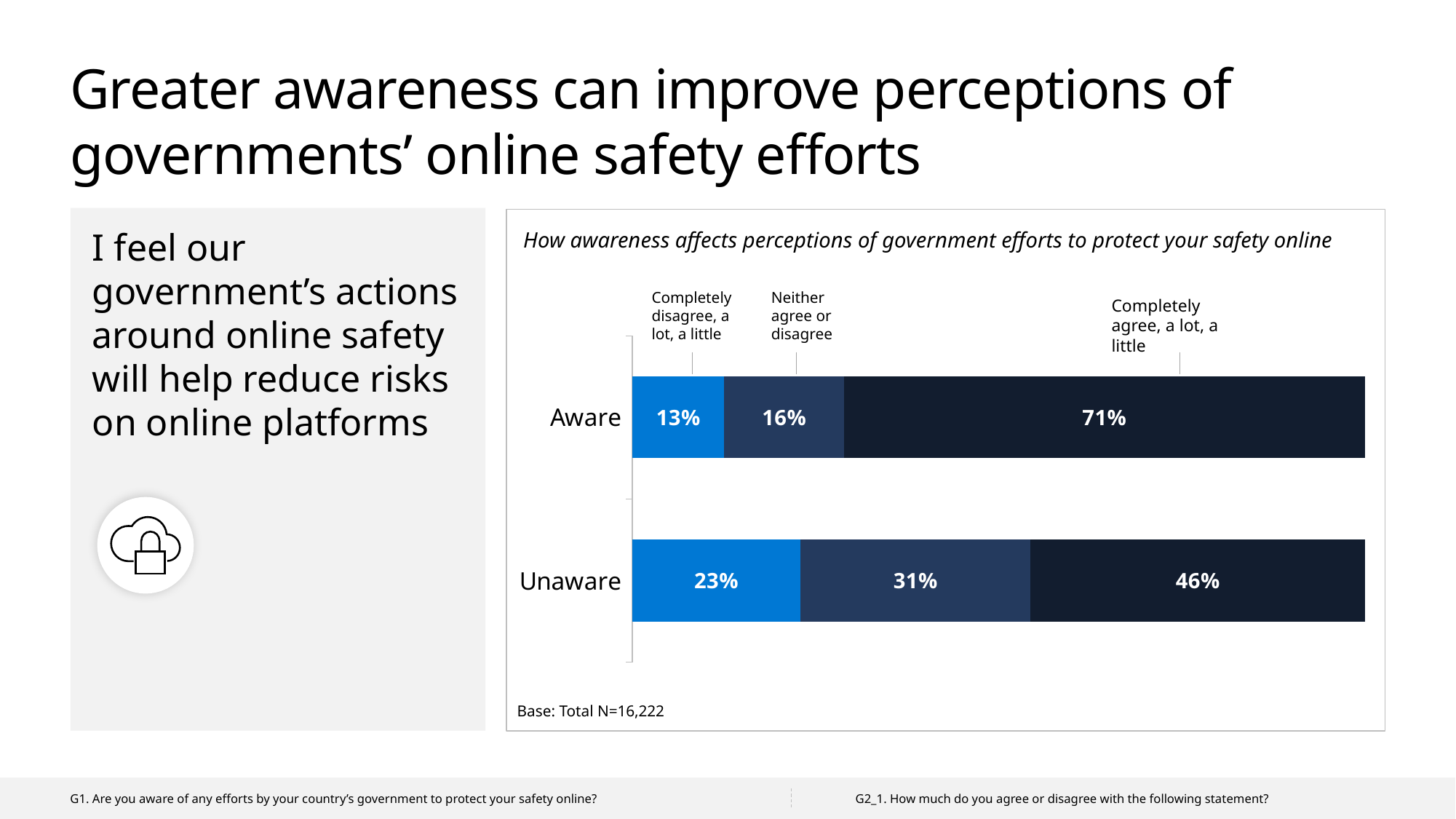
What percentage of Aware respondents neither agree nor disagree? 16% Which group has the higher share of respondents who agree (completely, a lot, a little): Aware or Unaware? Aware What is the difference in the disagree share between Unaware and Aware respondents? 10 percentage points How many groups (bars) are shown in the chart? 2 What percentage of Unaware respondents completely disagree, disagree a lot, or disagree a little? 23% What percentage of Aware respondents completely agree, agree a lot, or agree a little? 71% How many response categories are shown in each bar? 3 What is the difference in the agree share between Aware and Unaware respondents? 25 percentage points What percentage of Unaware respondents neither agree nor disagree? 31% What type of chart is shown on the slide? Stacked bar chart Which group has the larger share of respondents who neither agree nor disagree? Unaware What is the base sample size stated below the chart? Total N=16,222